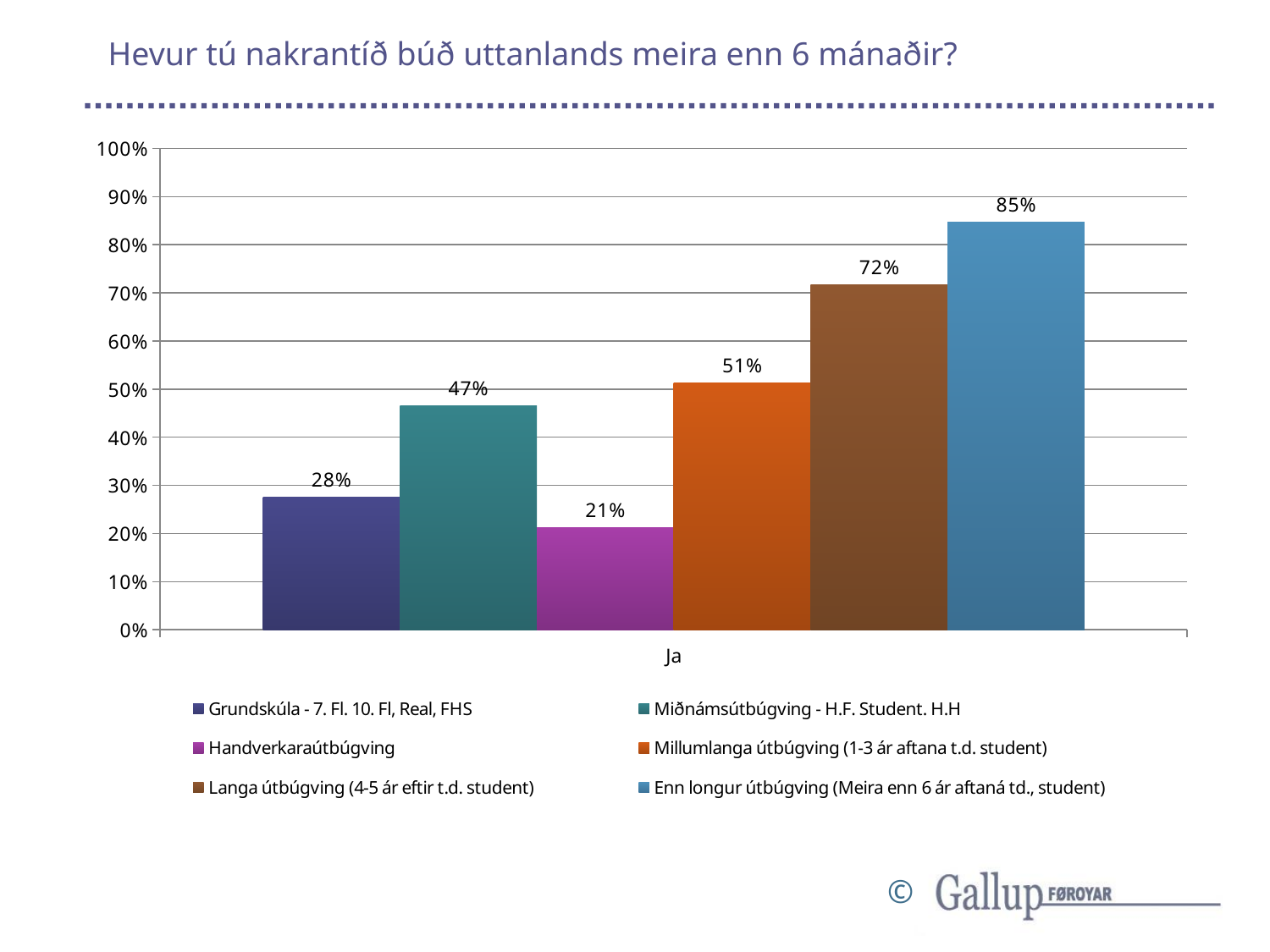
What is the value for Millumlanga útbúgving (1-3 ár aftana t.d. student)? 51% Which is larger, the value for Miðnámsútbúgving - H.F. Student. H.H or the value for Millumlanga útbúgving (1-3 ár aftana t.d. student)? Millumlanga útbúgving (1-3 ár aftana t.d. student) What is the category label shown on the x axis? Ja What is the value for Enn longur útbúgving (Meira enn 6 ár aftaná td., student)? 85% Which series has the highest value? Enn longur útbúgving (Meira enn 6 ár aftaná td., student) What kind of chart is shown on the slide? bar chart What is the value for Handverkaraútbúgving? 21% What is the difference between the values for Langa útbúgving (4-5 ár eftir t.d. student) and Miðnámsútbúgving - H.F. Student. H.H? 25% Which series has the lowest value? Handverkaraútbúgving How many series does the legend list? 6 What is the value for Grundskúla - 7. Fl. 10. Fl, Real, FHS? 28% Is the value for Langa útbúgving (4-5 ár eftir t.d. student) greater or less than 60%? greater